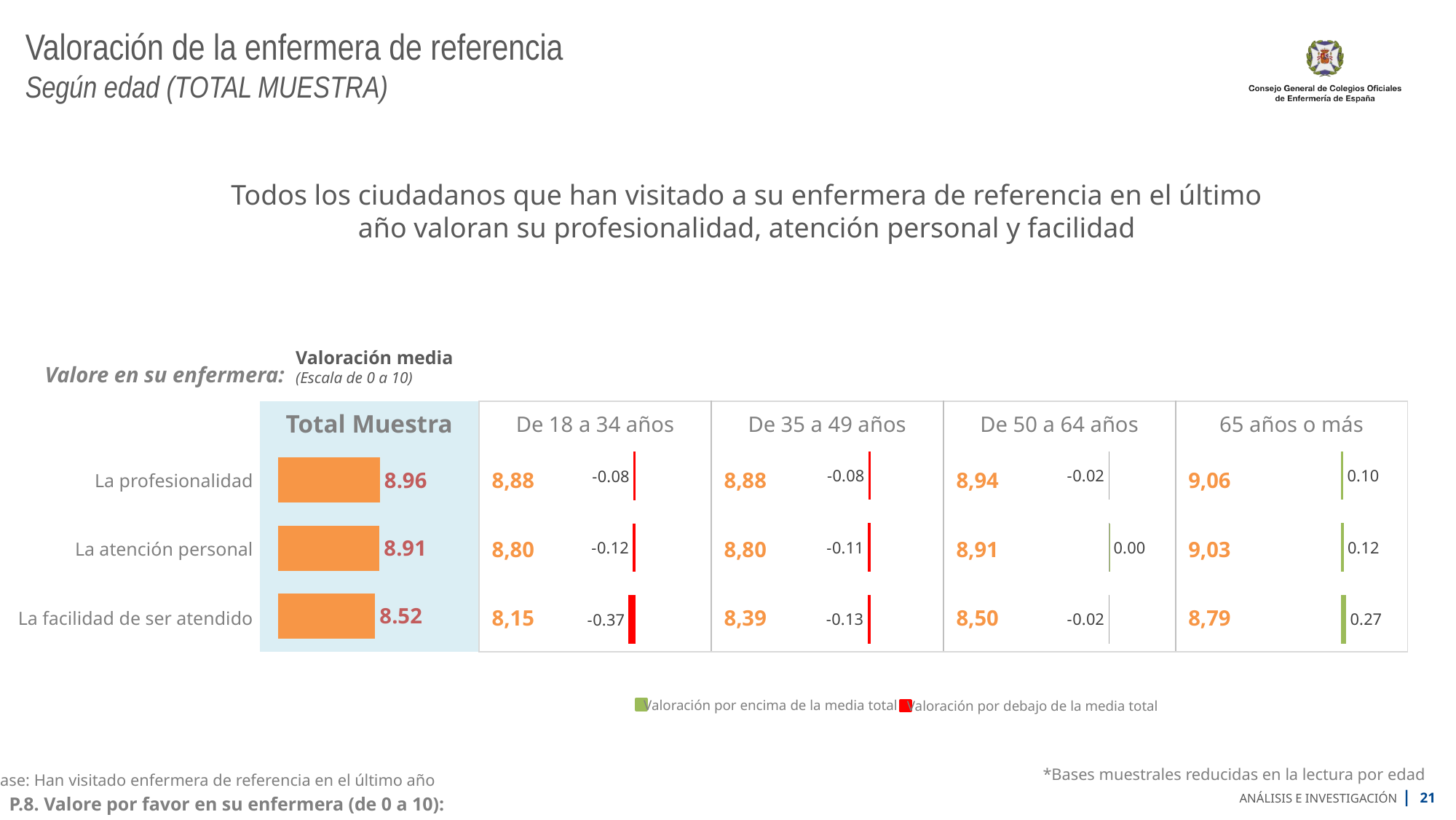
According to the legend, what does a green bar indicate? Valoración por encima de la media total In the Total Muestra bar chart, what is the value for La facilidad de ser atendido? 8.52 How many categories are shown in the Total Muestra bar chart? 3 In the Total Muestra bar chart, what is the value for La profesionalidad? 8.96 In the De 18 a 34 años column, what is the value for La facilidad de ser atendido? 8,15 In the Total Muestra bar chart, which category has the lowest value? La facilidad de ser atendido What kind of chart is used for the Total Muestra column? Bar chart In the De 18 a 34 años column, what is the deviation from the total mean for La facilidad de ser atendido? -0.37 In the 65 años o más column, what is the value for La atención personal? 9,03 In the Total Muestra bar chart, which category has the highest value? La profesionalidad Which is larger for La profesionalidad: the value for De 50 a 64 años or the value for 65 años o más? 65 años o más In the Total Muestra bar chart, what is the difference between La profesionalidad and La facilidad de ser atendido? 0.44